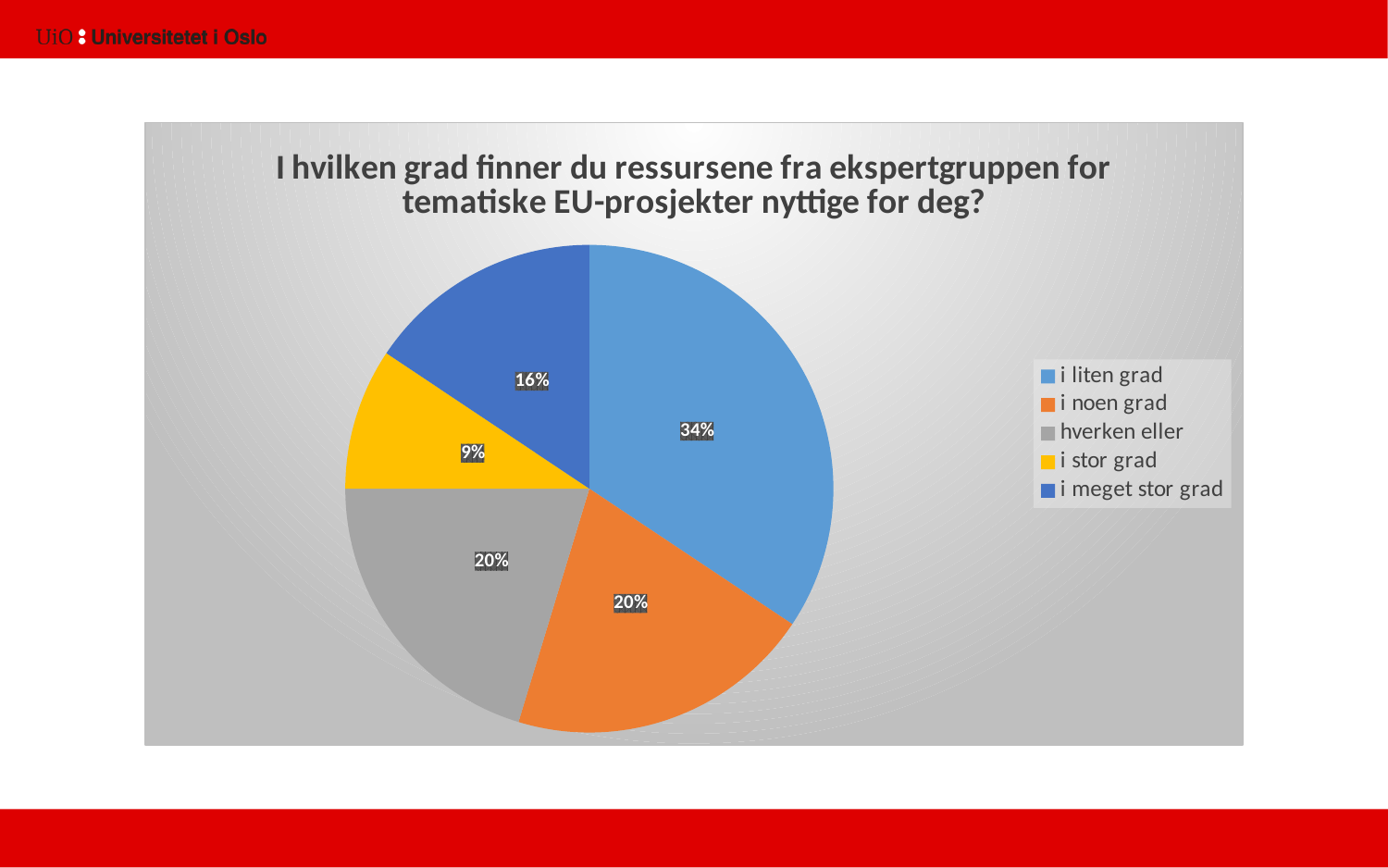
What kind of chart is shown on the slide? pie chart What share of the pie does "i meget stor grad" have? 16% What is the difference in percentage points between "i liten grad" and "i meget stor grad"? 18 What share of the pie does "i noen grad" have? 20% What colour is the slice for "i stor grad"? yellow Which category has the largest slice of the pie? i liten grad What share of the pie does "hverken eller" have? 20% Which category has the smallest slice of the pie? i stor grad Which is larger, the slice for "i meget stor grad" or the slice for "i stor grad"? i meget stor grad How many categories does the pie chart have? 5